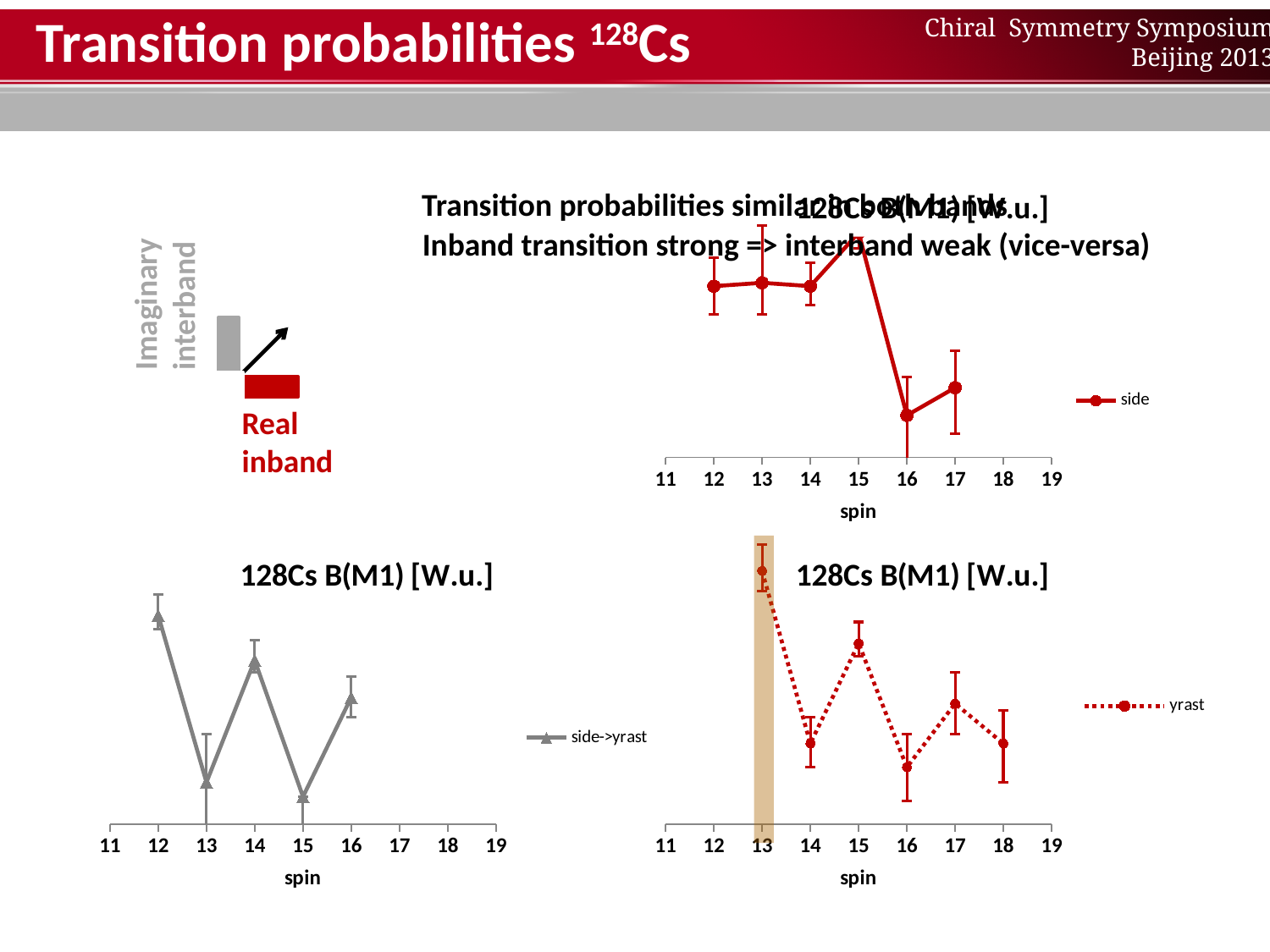
In the top-right chart (series 'side'), at which spin is the plotted value lowest? 16 In the bottom-left chart (series 'side->yrast'), at which spin is the value highest? 12 How many data points are plotted in the top-right chart (series 'side')? 6 In the top-right chart (series 'side'), at which spin is the plotted value highest? 15 In the bottom-right chart (series 'yrast'), does the value rise or fall from spin 13 to spin 14? fall How many data points are plotted in the bottom-left chart (series 'side->yrast')? 5 In the bottom-left chart (series 'side->yrast'), which spin has the larger value, 14 or 16? 14 What kind of chart is the bottom-left chart with the 'side->yrast' series? line chart In the bottom-right chart (series 'yrast'), at which spin is the value lowest? 16 In the bottom-right chart (series 'yrast'), at which spin is the value highest? 13 What series name does the legend of the bottom-right chart show? yrast In the bottom-left chart (series 'side->yrast'), at which spin is the value lowest? 15